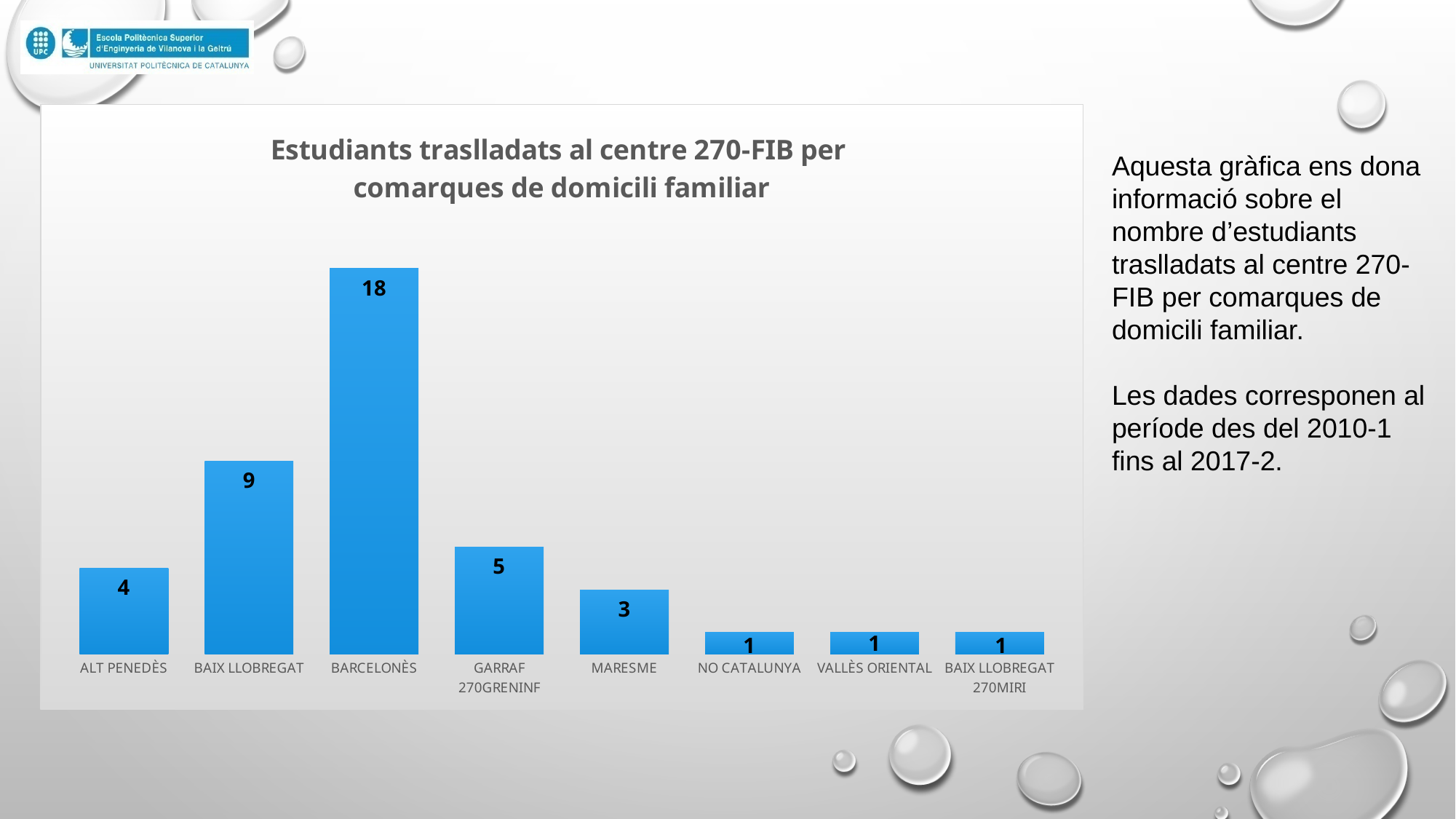
What is the difference between the values for BARCELONÈS and BAIX LLOBREGAT? 9 What is the title of the chart? Estudiants traslladats al centre 270-FIB per comarques de domicili familiar What is the value for MARESME? 3 What is the difference between the values for GARRAF 270GRENINF and ALT PENEDÈS? 1 What is the value for GARRAF 270GRENINF? 5 What kind of chart is shown? Bar chart What is the value for NO CATALUNYA? 1 Which category has the highest value? BARCELONÈS How many categories are shown on the x axis? 8 What is the value for BARCELONÈS? 18 What is the value for BAIX LLOBREGAT? 9 Which is larger, the value for ALT PENEDÈS or the value for MARESME? ALT PENEDÈS